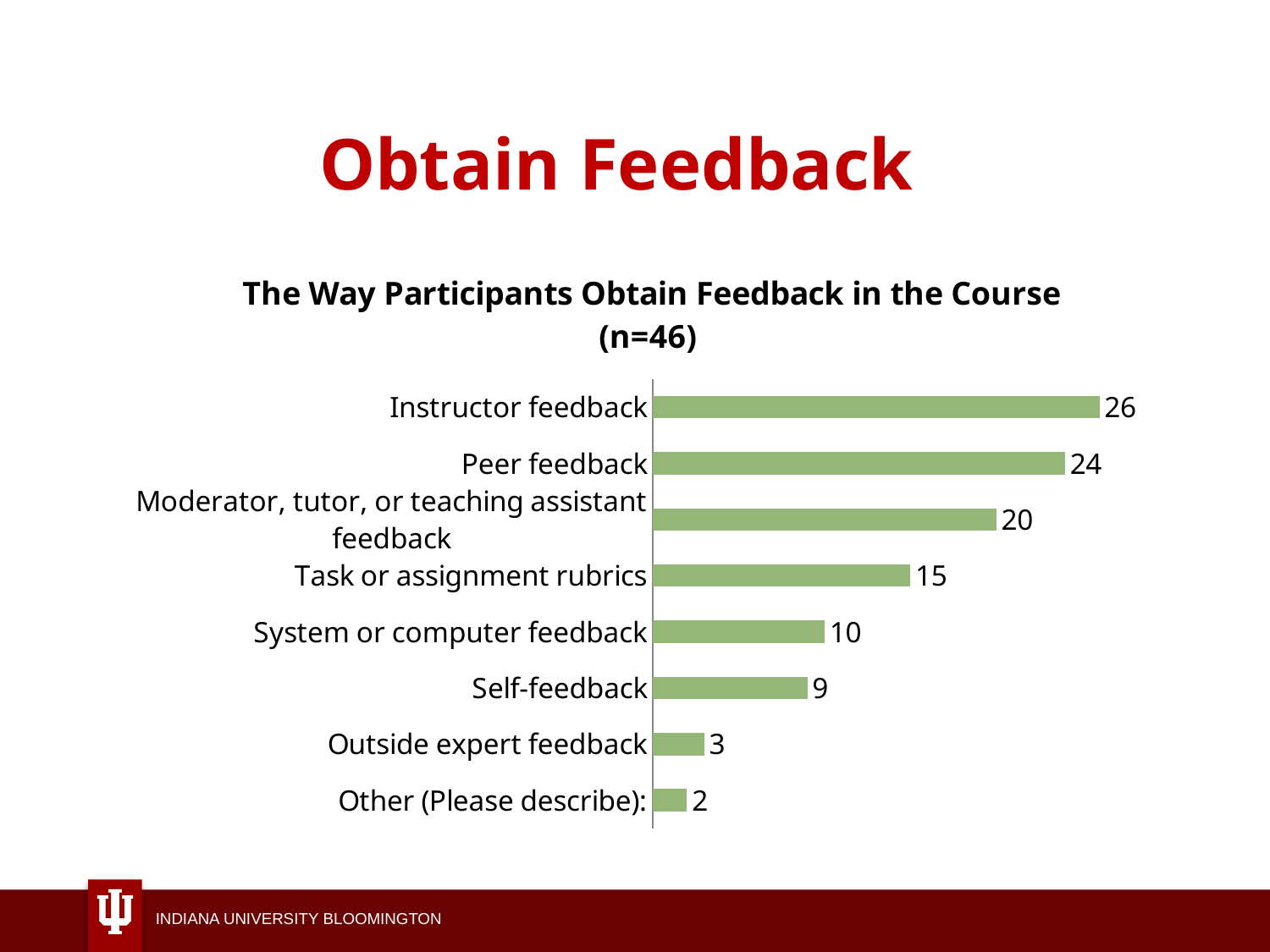
Which category has the lowest value? Other (Please describe): What is the value for Task or assignment rubrics? 15 How many categories are shown in the chart? 8 What is the difference between the values for System or computer feedback and Outside expert feedback? 7 What is the value for Moderator, tutor, or teaching assistant feedback? 20 Which category has the highest value? Instructor feedback What kind of chart is shown on the slide? Bar chart What is the value for Instructor feedback? 26 What is the title of the chart? The Way Participants Obtain Feedback in the Course (n=46) Which is larger, the value for Peer feedback or the value for Task or assignment rubrics? Peer feedback What is the difference between the values for Instructor feedback and Peer feedback? 2 What is the value for Self-feedback? 9